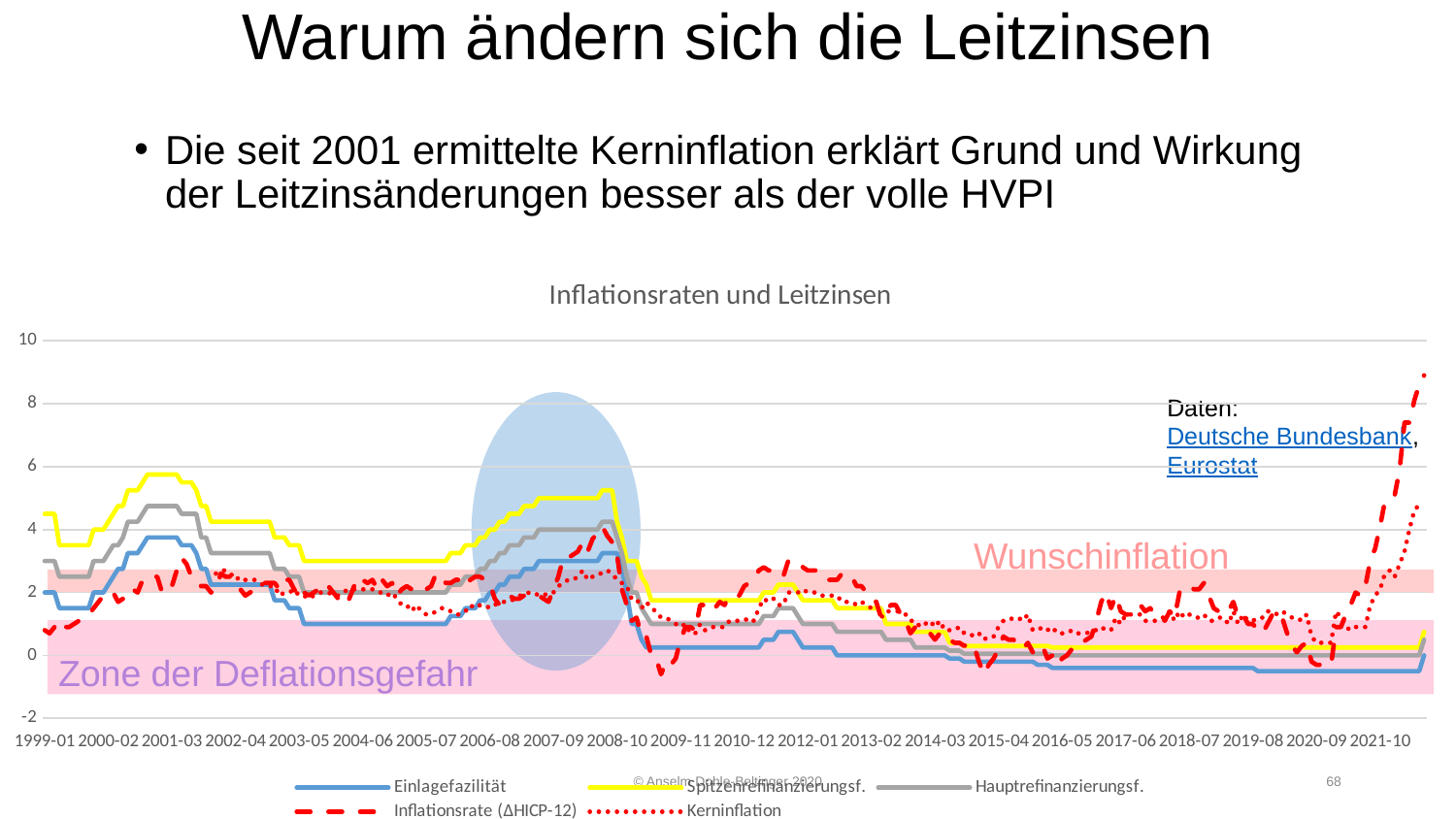
Is the value of Einlagefazilität at 2020-09 greater or less than 0? less What kind of chart is shown on the slide? line chart Which colour is used for the Einlagefazilität line? blue What is the title of the chart? Inflationsraten und Leitzinsen Is the value of Inflationsrate (ΔHICP-12) at 2021-10 greater or less than 6? less Is the value of Kerninflation at 2021-10 greater or less than 4? less Which series has the highest value at 2001-03? Spitzenrefinanzierungsf. Which series has the lowest value at 2020-09? Einlagefazilität Does the Spitzenrefinanzierungsf. line rise or fall between 2005-07 and 2008-10? rise At 2007-09, which is larger: Spitzenrefinanzierungsf. or Einlagefazilität? Spitzenrefinanzierungsf. How many series does the legend of the chart list? 5